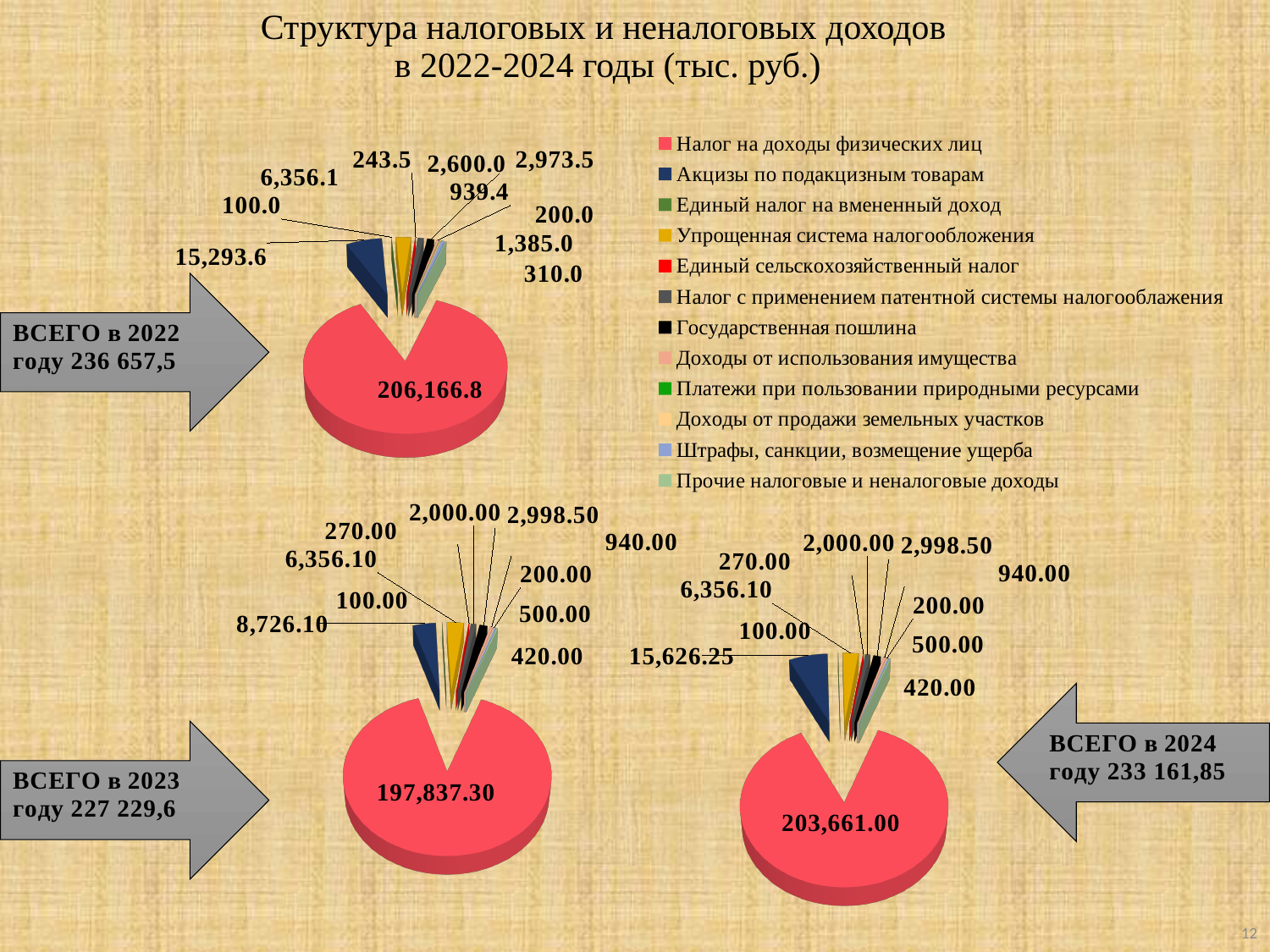
In the 2023 pie chart, what is the value of the dark blue slice (Акцизы по подакцизным товарам)? 8,726.10 In the 2022 pie chart, what is the value of the largest slice? 206,166.8 In the 2022 pie chart, what is the value of the dark blue slice (Акцизы по подакцизным товарам)? 15,293.6 What is the difference between the largest slice in the 2022 pie chart (206,166.8) and the largest slice in the 2023 pie chart (197,837.30)? 8,329.5 In the 2024 pie chart, what is the value of the largest slice? 203,661.00 Is the largest slice bigger in the 2022 pie chart or in the 2023 pie chart? 2022 In the 2023 pie chart, what is the value of the largest slice? 197,837.30 In the 2024 pie chart, what is the value of the dark blue slice (Акцизы по подакцизным товарам)? 15,626.25 In the 2022 pie chart, what is the smallest labelled value? 100.0 Which legend category does the largest slice in each pie chart represent? Налог на доходы физических лиц What kind of chart is used to show the structure of revenues for 2022? pie chart How many categories does the legend list? 12